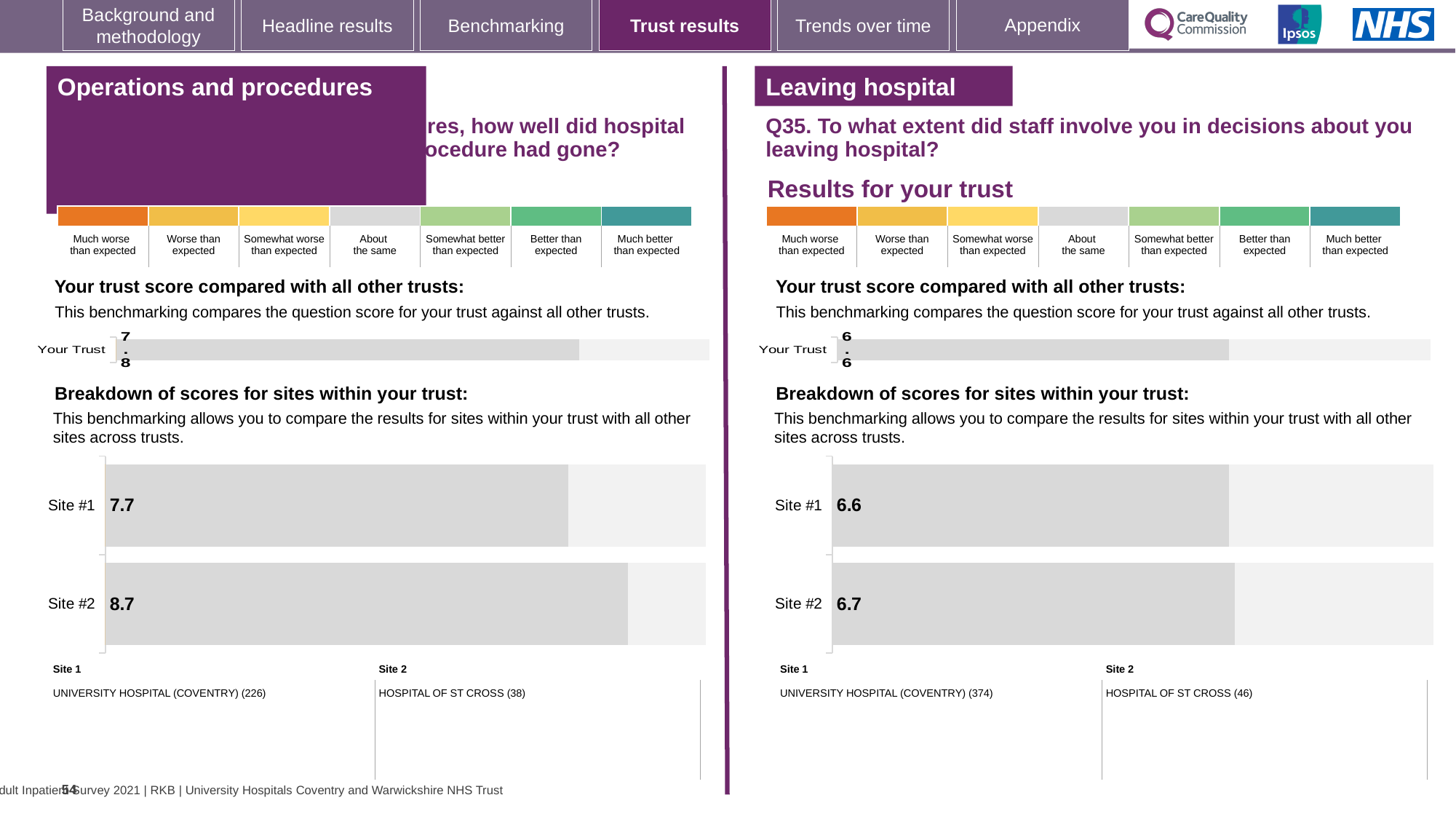
Is the Site #1 score in the 'Operations and procedures' chart on the left larger or smaller than the Site #1 score in the 'Leaving hospital' chart on the right? Larger What kind of chart is used for the site breakdown on the left side of the slide? Bar chart In the 'Operations and procedures' site breakdown chart on the left, what is the score for Site #2? 8.7 In the 'Operations and procedures' 'Your Trust' chart on the left, what is the trust score? 7.8 In the 'Leaving hospital' 'Your Trust' chart on the right, what is the trust score? 6.6 In the 'Leaving hospital' site breakdown chart on the right, what is the score for Site #1? 6.6 In the 'Leaving hospital' site breakdown chart on the right, what is the difference between the Site #2 and Site #1 scores? 0.1 In the 'Operations and procedures' site breakdown chart on the left, what is the difference between the Site #2 and Site #1 scores? 1.0 In the 'Operations and procedures' site breakdown chart on the left, which site has the higher score? Site #2 In the 'Operations and procedures' site breakdown chart on the left, what is the score for Site #1? 7.7 In the 'Leaving hospital' site breakdown chart on the right, what is the score for Site #2? 6.7 How many sites are shown in the 'Leaving hospital' site breakdown chart on the right? 2